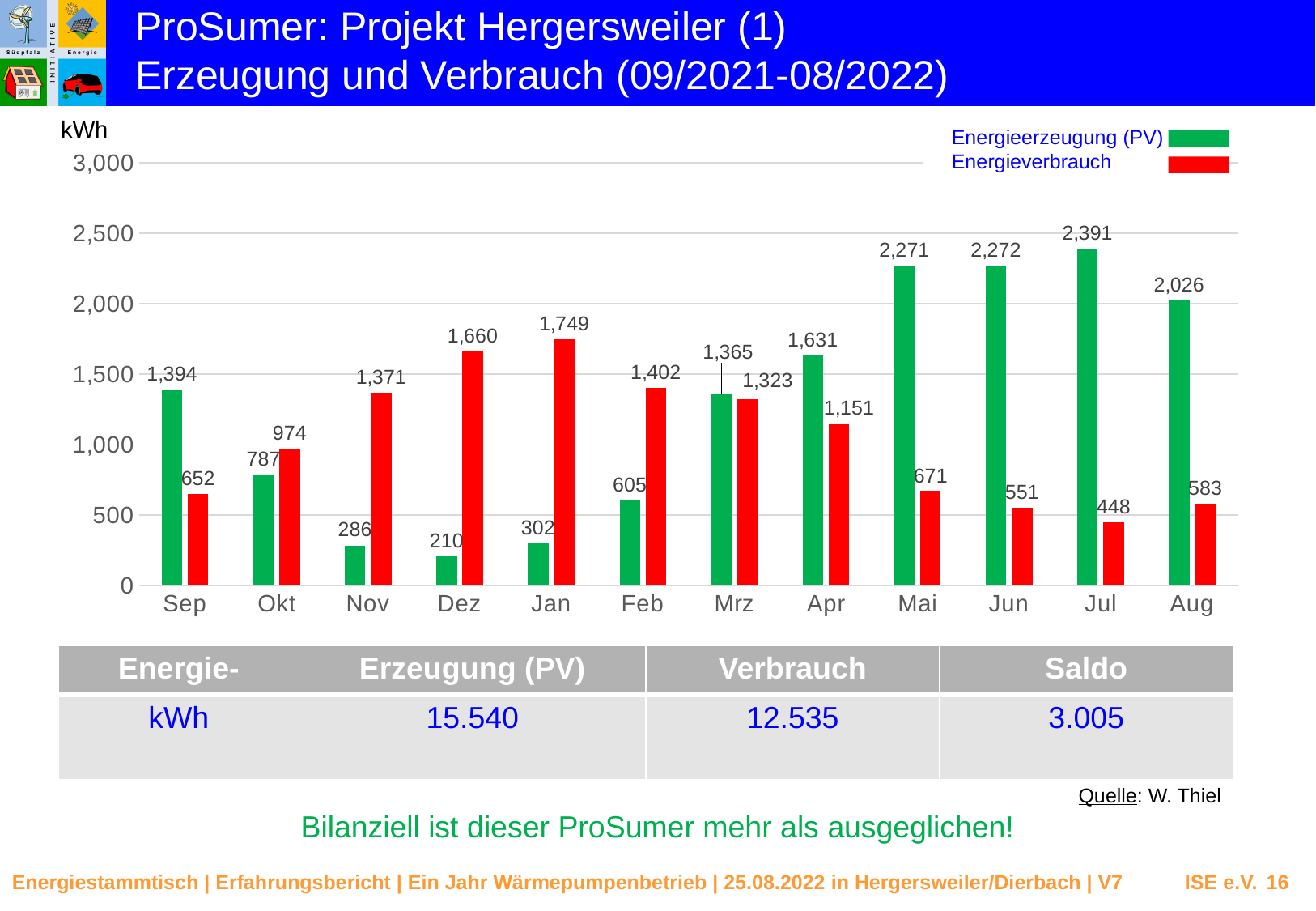
How many months are shown on the x axis? 12 What is the Energieerzeugung (PV) value for Jul? 2,391 What is the Energieerzeugung (PV) value for Dez? 210 What is the difference between Energieerzeugung (PV) and Energieverbrauch in Jul? 1,943 How many series does the legend list? 2 What kind of chart is shown on the slide? Bar chart What is the Energieverbrauch value for Jan? 1,749 Which month has the lowest Energieverbrauch? Jul Which month has the highest Energieerzeugung (PV)? Jul Which month has the lowest Energieerzeugung (PV)? Dez Which colour represents Energieverbrauch in the chart? Red In Okt, which is larger: Energieerzeugung (PV) or Energieverbrauch? Energieverbrauch